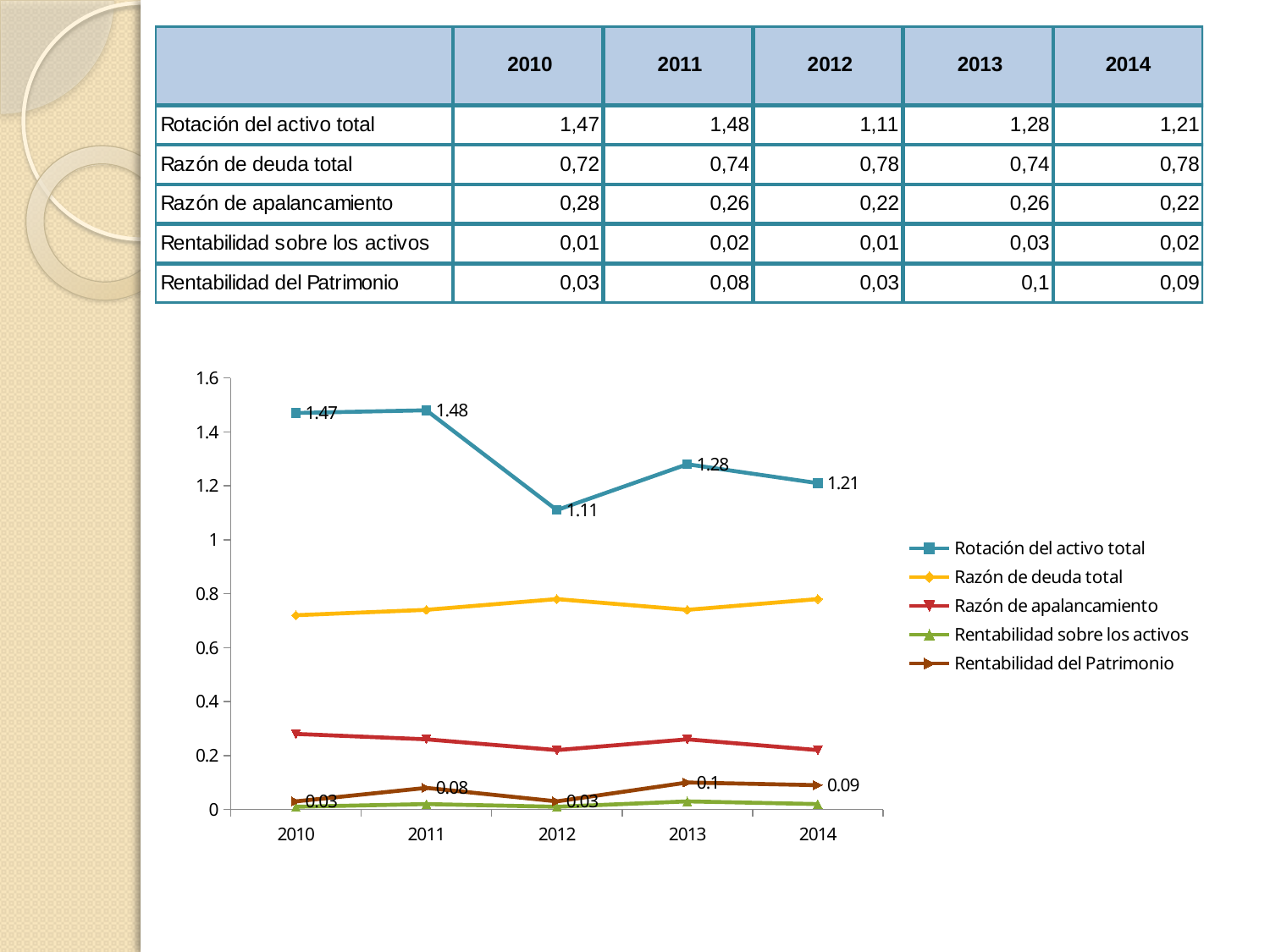
Which year has the larger Rentabilidad del Patrimonio, 2011 or 2014? 2014 Is the value for Razón de apalancamiento in 2010 greater or less than 0.4? less Does Rotación del activo total rise or fall from 2011 to 2012? fall Is the value for Razón de deuda total in 2012 greater or less than 0.6? greater How many years are shown on the x axis of the chart? 5 What is the value of Rentabilidad del Patrimonio in 2013 on the chart? 0.1 How many series does the chart legend list? 5 What kind of chart is shown on the slide? line chart In which year is Rotación del activo total highest? 2011 What is the difference between Rotación del activo total in 2011 and in 2012? 0.37 What is the value of Rotación del activo total in 2012 on the chart? 1.11 In which year is Rotación del activo total lowest? 2012